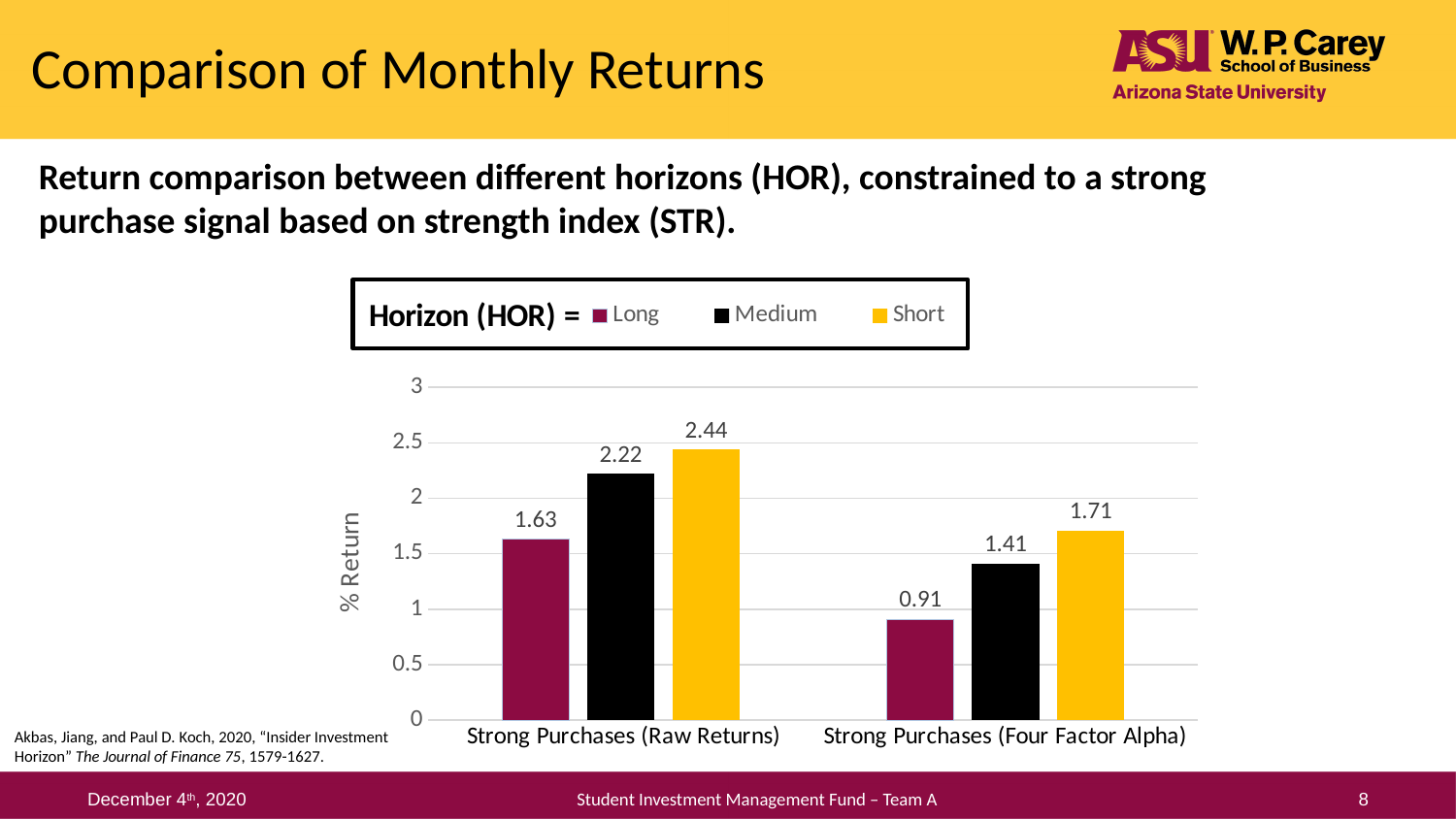
How many series does the legend list? 3 What is the difference between the Short and Long values for Strong Purchases (Raw Returns)? 0.81 Which is larger: the Long value for Raw Returns or the Short value for Four Factor Alpha? Short value for Four Factor Alpha Is the Long value for Strong Purchases (Four Factor Alpha) greater or less than 1? less What kind of chart is shown on the slide? Bar chart Which horizon has the lowest value for Strong Purchases (Four Factor Alpha)? Long Which horizon has the highest value for Strong Purchases (Raw Returns)? Short What is the Short horizon value for Strong Purchases (Four Factor Alpha)? 1.71 What is the Medium horizon value for Strong Purchases (Raw Returns)? 2.22 What is the label of the vertical axis? % Return What is the difference between the Medium values for Raw Returns and Four Factor Alpha? 0.81 What is the Long horizon value for Strong Purchases (Raw Returns)? 1.63